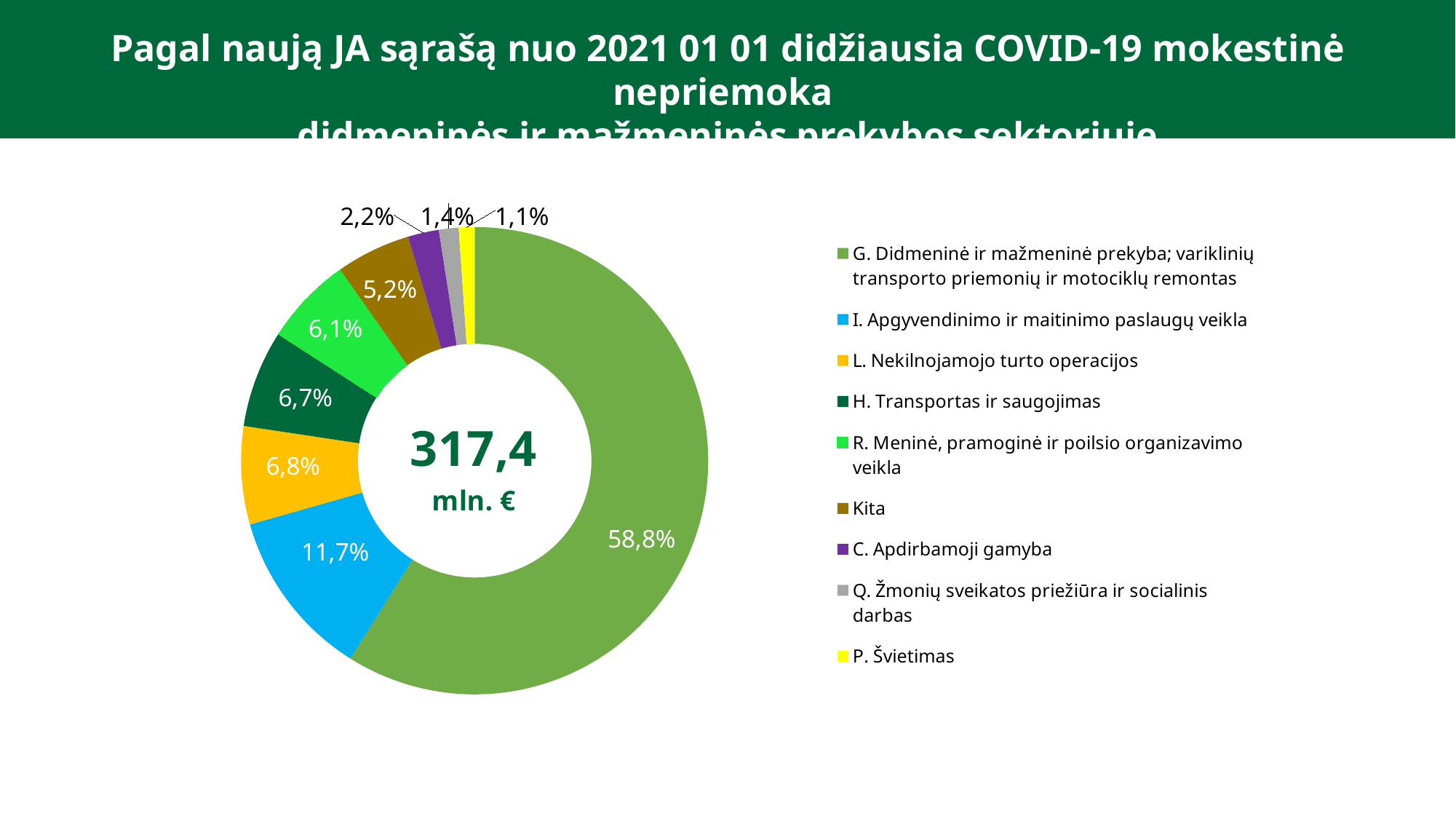
What share of the pie does G. Didmeninė ir mažmeninė prekyba; variklinių transporto priemonių ir motociklų remontas hold? 58,8% Which category has the smallest slice? P. Švietimas What is the value shown for P. Švietimas? 1,1% What is the value shown for Kita? 5,2% Which category has the largest slice? G. Didmeninė ir mažmeninė prekyba; variklinių transporto priemonių ir motociklų remontas Which is larger, the slice for R. Meninė, pramoginė ir poilsio organizavimo veikla or the slice for C. Apdirbamoji gamyba? R. Meninė, pramoginė ir poilsio organizavimo veikla What kind of chart is shown on the slide? Pie (donut) chart What is the difference in percentage points between G. Didmeninė ir mažmeninė prekyba and I. Apgyvendinimo ir maitinimo paslaugų veikla? 47,1 What is the value shown for L. Nekilnojamojo turto operacijos? 6,8% How many categories does the chart show? 9 What total value is printed in the centre of the chart? 317,4 mln. € What is the value shown for I. Apgyvendinimo ir maitinimo paslaugų veikla? 11,7%